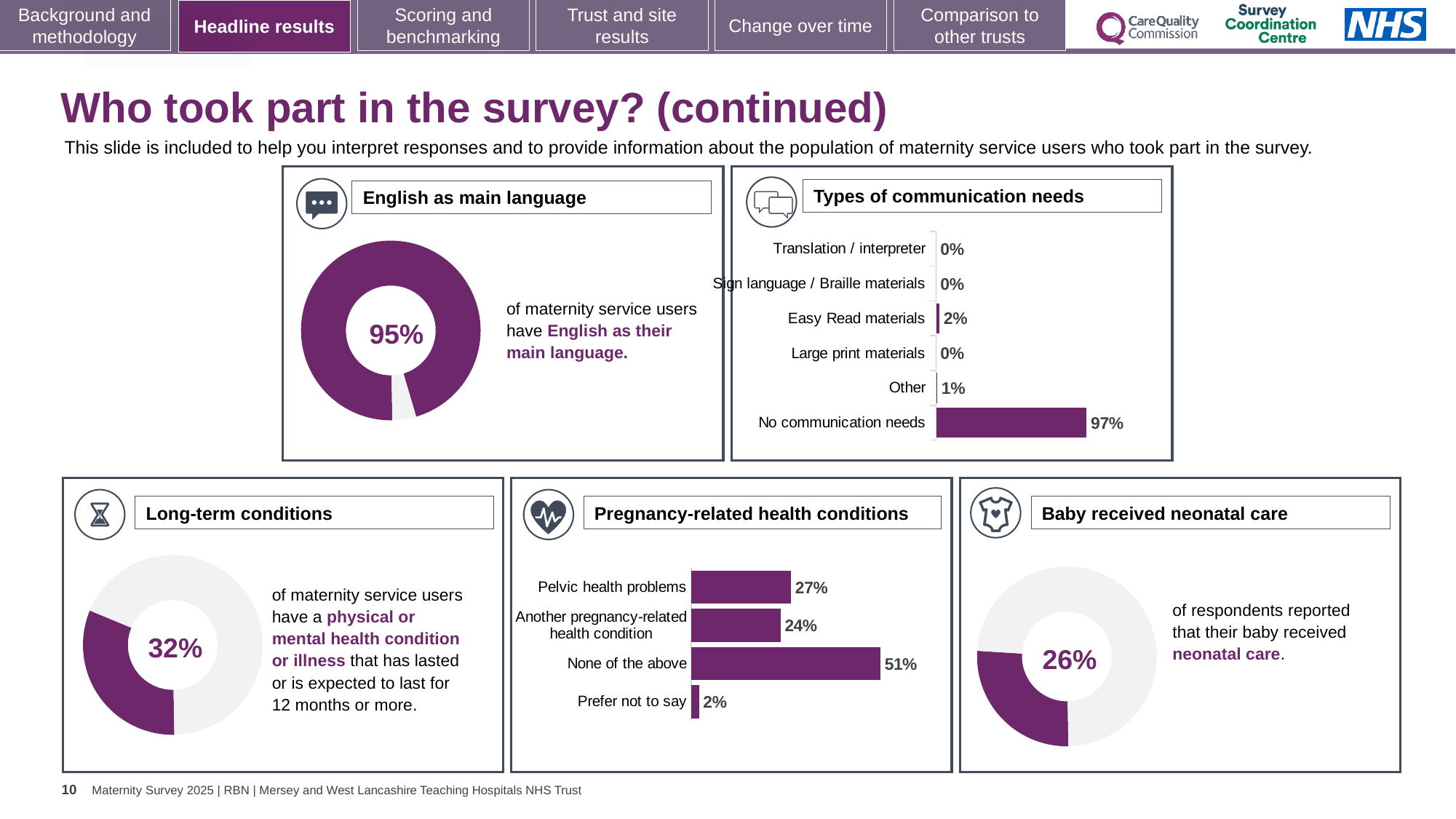
In the 'Pregnancy-related health conditions' chart, which category has the lowest value? Prefer not to say In the 'Types of communication needs' chart, what is the value for 'No communication needs'? 97% In the 'Pregnancy-related health conditions' chart, what is the value for 'Pelvic health problems'? 27% In the 'Pregnancy-related health conditions' chart, what is the difference between 'None of the above' and 'Another pregnancy-related health condition'? 27% In the 'Long-term conditions' chart, what percentage of maternity service users have a physical or mental health condition or illness? 32% In the 'Types of communication needs' chart, which category has the highest value? No communication needs In the 'English as main language' chart, what percentage of maternity service users have English as their main language? 95% In the 'Pregnancy-related health conditions' chart, which is larger: 'Pelvic health problems' or 'Another pregnancy-related health condition'? Pelvic health problems In the 'Types of communication needs' chart, what is the value for 'Easy Read materials'? 2% How many categories are shown in the 'Types of communication needs' chart? 6 What type of chart is used for 'Types of communication needs'? Bar chart In the 'Baby received neonatal care' chart, what percentage of respondents reported that their baby received neonatal care? 26%